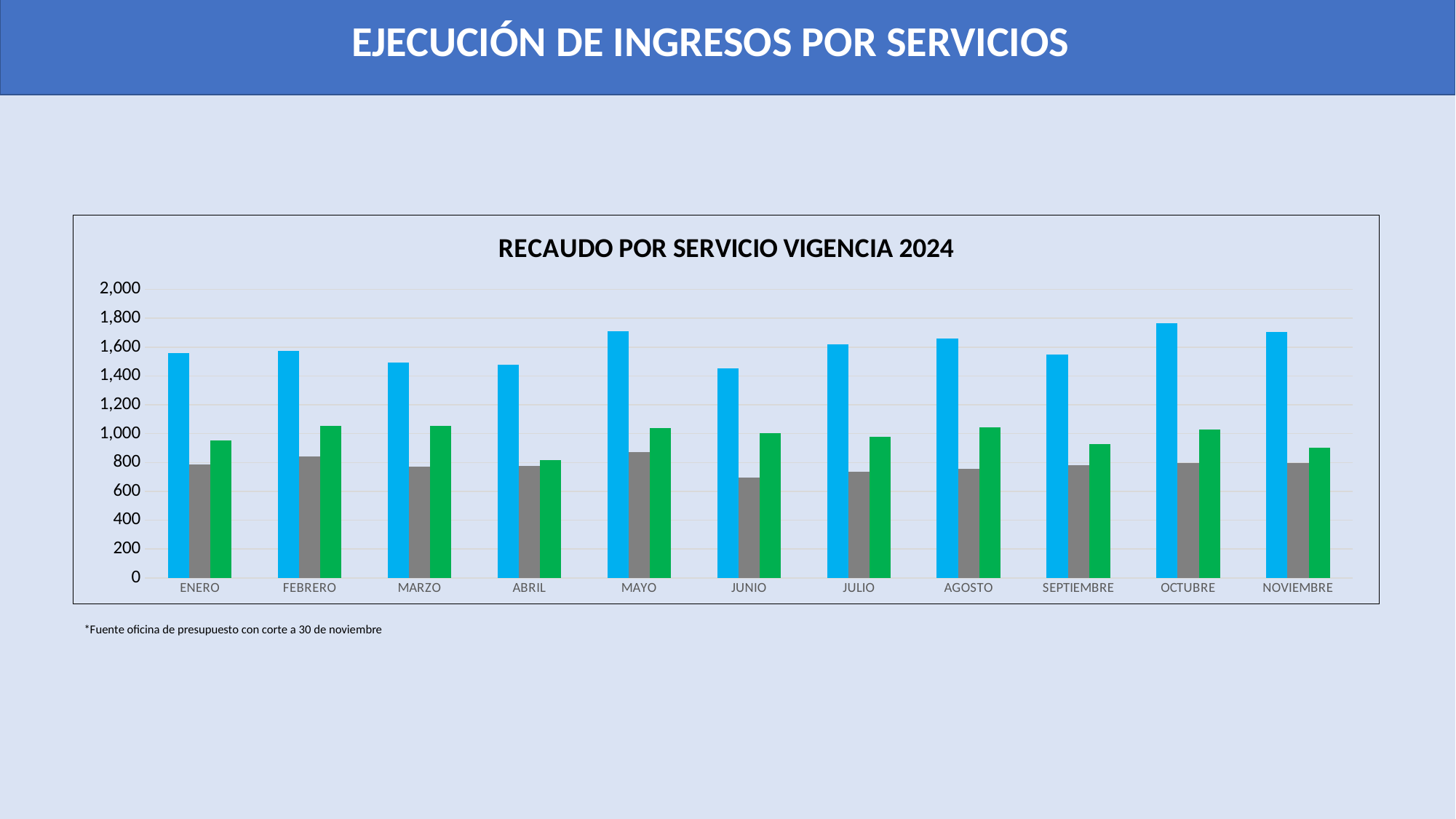
Is the value of the gray bar for JUNIO greater or less than 800? less How many months are shown on the x axis of the chart? 11 Which month has the lowest green bar? ABRIL Is the value of the blue bar for ENERO greater or less than 1,400? greater How many bars are plotted for each month in the chart? 3 Is the value of the green bar for ABRIL greater or less than 1,000? less In ENERO, which bar is larger, the gray bar or the green bar? the green bar In OCTUBRE, which bar is larger, the blue bar or the green bar? the blue bar What is the title of the chart? RECAUDO POR SERVICIO VIGENCIA 2024 What kind of chart is shown on the slide? bar chart